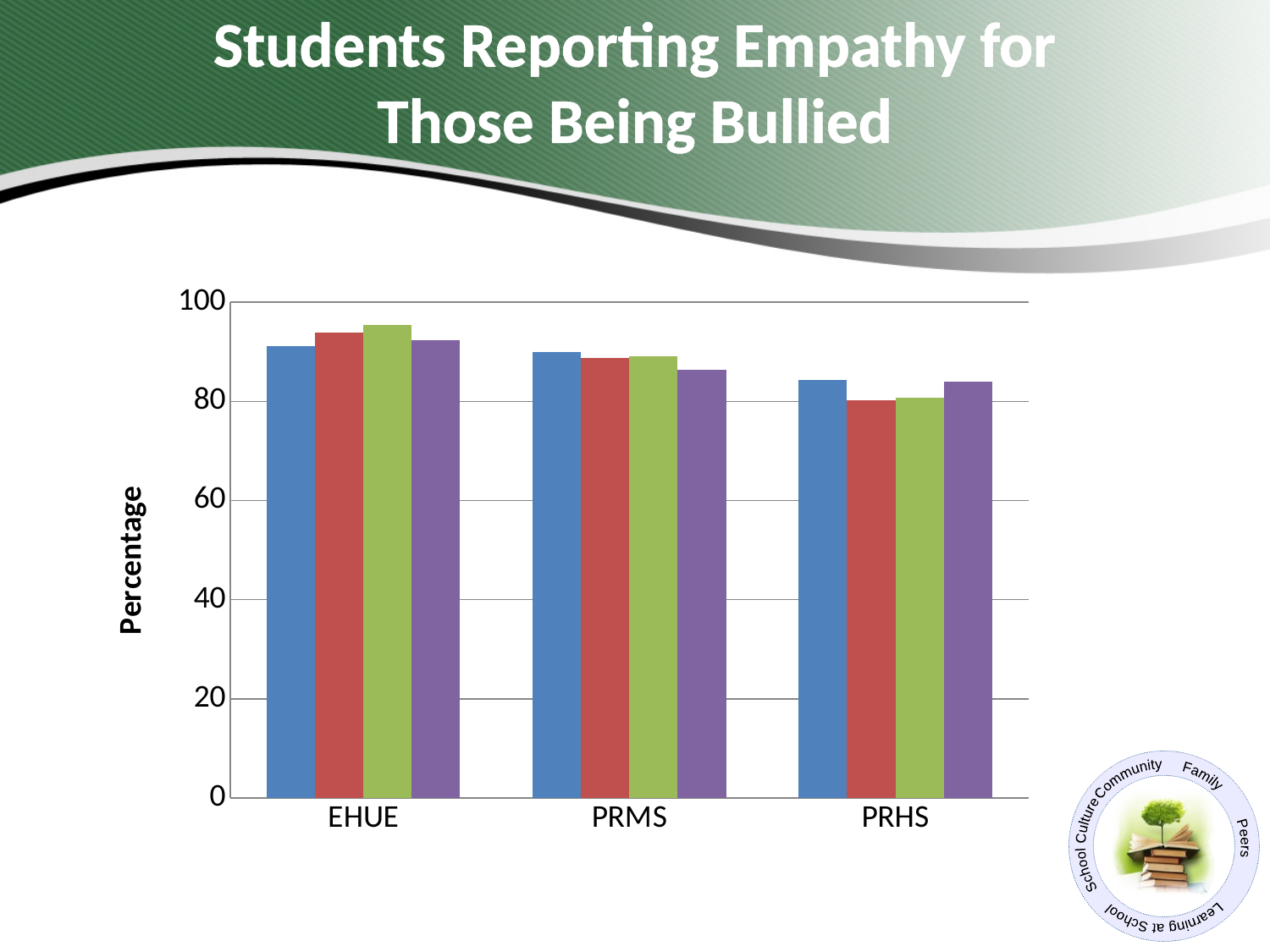
What is the title of the slide containing the chart? Students Reporting Empathy for Those Being Bullied Within the PRHS category, which bar is larger, the blue bar or the red bar? blue What kind of chart is shown on the slide? bar chart Is the value of the green bar for EHUE greater or less than 100? less Is the value of the purple bar for PRMS greater or less than 80? greater What is the label of the vertical axis of the chart? Percentage Which category has the lowest blue bar? PRHS Do the blue bars rise or fall moving from EHUE to PRHS along the x axis? fall Is the value of the blue bar for EHUE greater or less than 80? greater How many categories are shown on the x axis of the chart? 3 How many bars are plotted for each category in the chart? 4 Which category has the larger green bar, EHUE or PRHS? EHUE